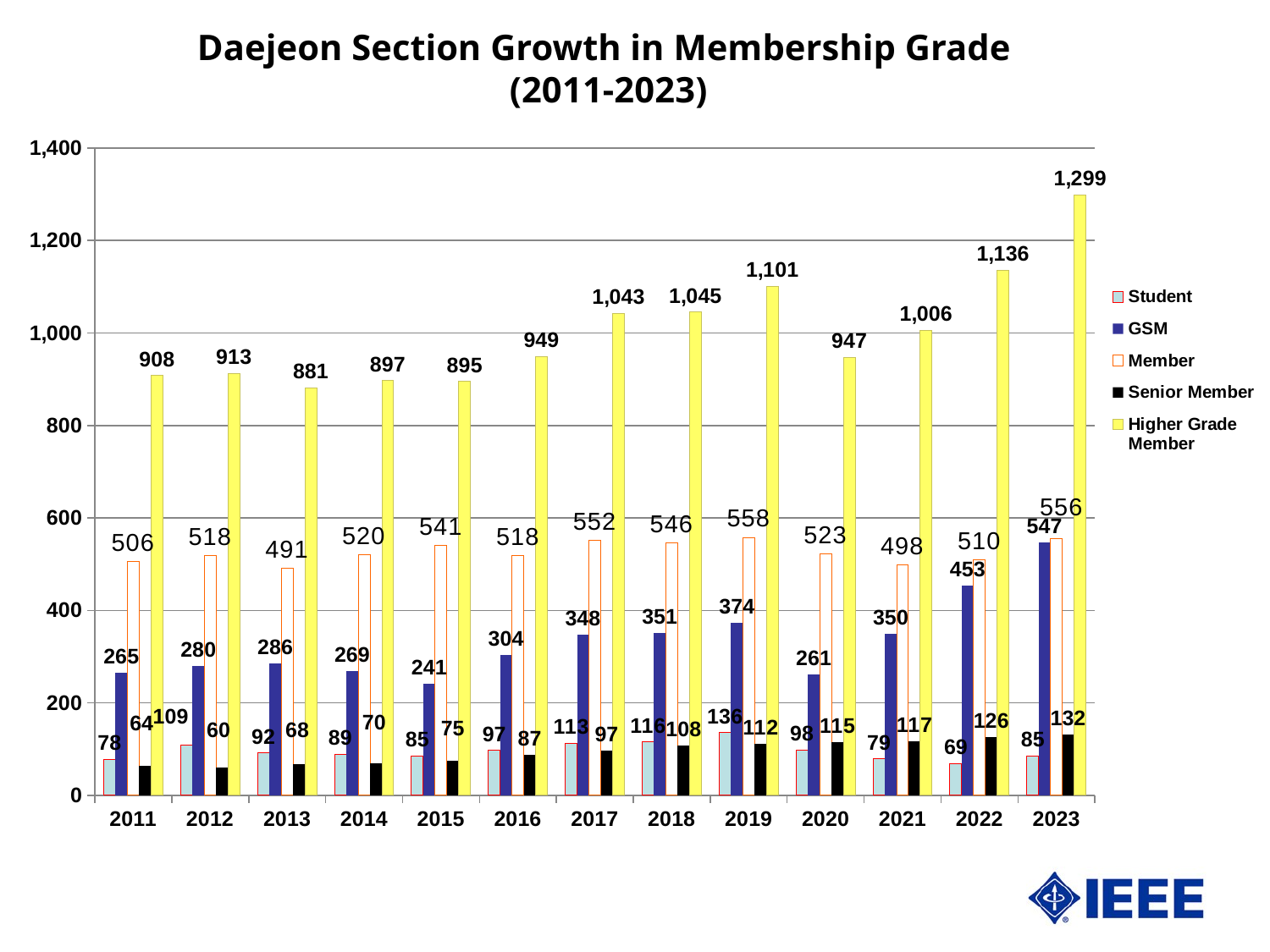
Does the Senior Member value rise or fall from 2011 to 2023? Rise What is the Senior Member value in 2011? 64 In which year is the Higher Grade Member value lowest? 2013 Which is larger, the GSM value in 2022 or the Member value in 2022? Member value in 2022 What is the GSM value in 2019? 374 What is the difference between the Higher Grade Member values in 2023 and 2022? 163 What kind of chart is shown on the slide? Bar chart How many years are shown on the x axis? 13 What is the value for Higher Grade Member in 2023? 1,299 In which year is the Student value highest? 2019 What is the Member value in 2015? 541 How many series does the legend list? 5